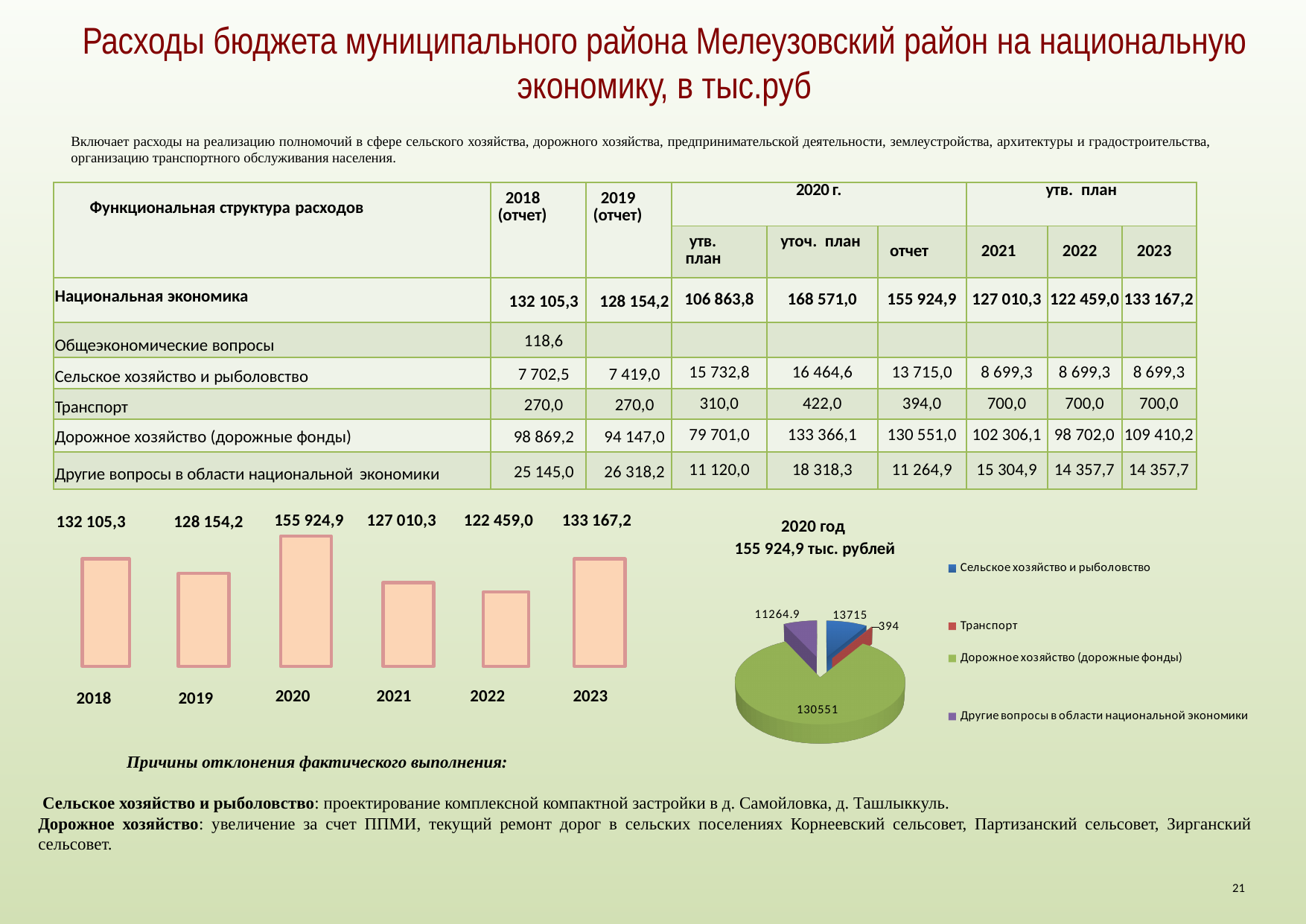
In the bar chart at the bottom left, what is the value for 2020? 155 924,9 In the pie chart titled "2020 год", which category has the largest slice? Дорожное хозяйство (дорожные фонды) How many bars are shown in the bar chart at the bottom left? 6 In the bar chart at the bottom left, what is the difference between the values for 2020 and 2019? 27 770,7 In the bar chart at the bottom left, which year has the lowest value? 2022 In the pie chart titled "2020 год", what is the value for Транспорт? 394 In the bar chart at the bottom left, which year has the highest value? 2020 How many entries does the legend of the pie chart titled "2020 год" list? 4 In the bar chart at the bottom left, what is the value for 2022? 122 459,0 In the bar chart at the bottom left, which is larger, the value for 2018 or the value for 2021? 2018 In the pie chart titled "2020 год", what is the value for Дорожное хозяйство (дорожные фонды)? 130551 What kind of chart is shown at the bottom left of the slide? bar chart